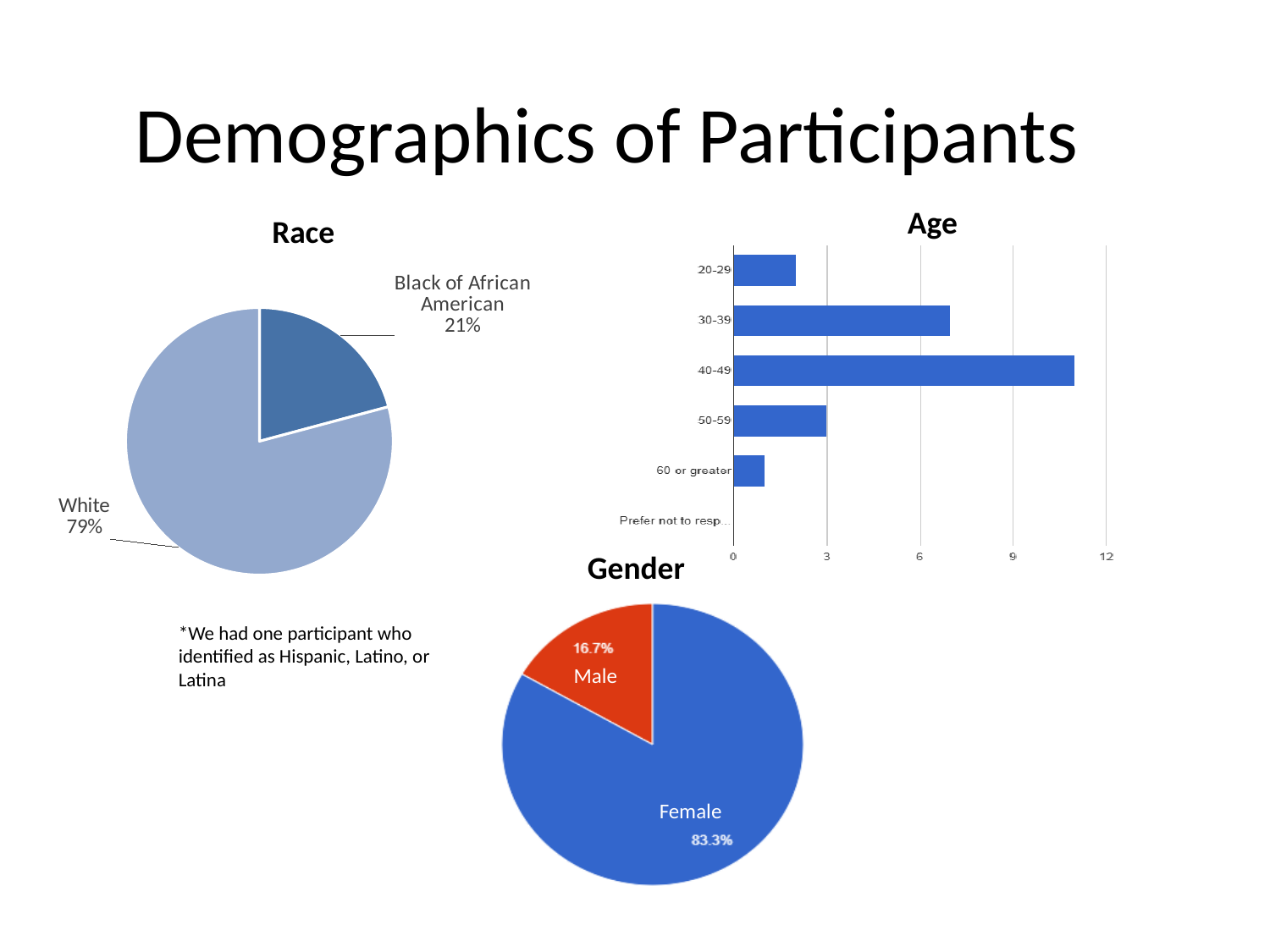
In the Gender chart, what percentage of participants are Male? 16.7% In the Gender chart, what percentage of participants are Female? 83.3% In the Race chart, what share of participants are Black of African American? 21% How many age categories are shown on the Age chart? 6 In the Age chart, which age group has the highest count? 40-49 In the Age chart, is the value for 40-49 greater or less than 9? greater In the Race chart, what share of participants are White? 79% In the Gender chart, which slice is larger, Male or Female? Female What kind of chart is the Age chart? bar chart In the Age chart, is the value for 20-29 greater or less than 3? less What kind of chart is the Race chart? pie chart In the Gender chart, what is the difference between the Female and Male percentages? 66.6%